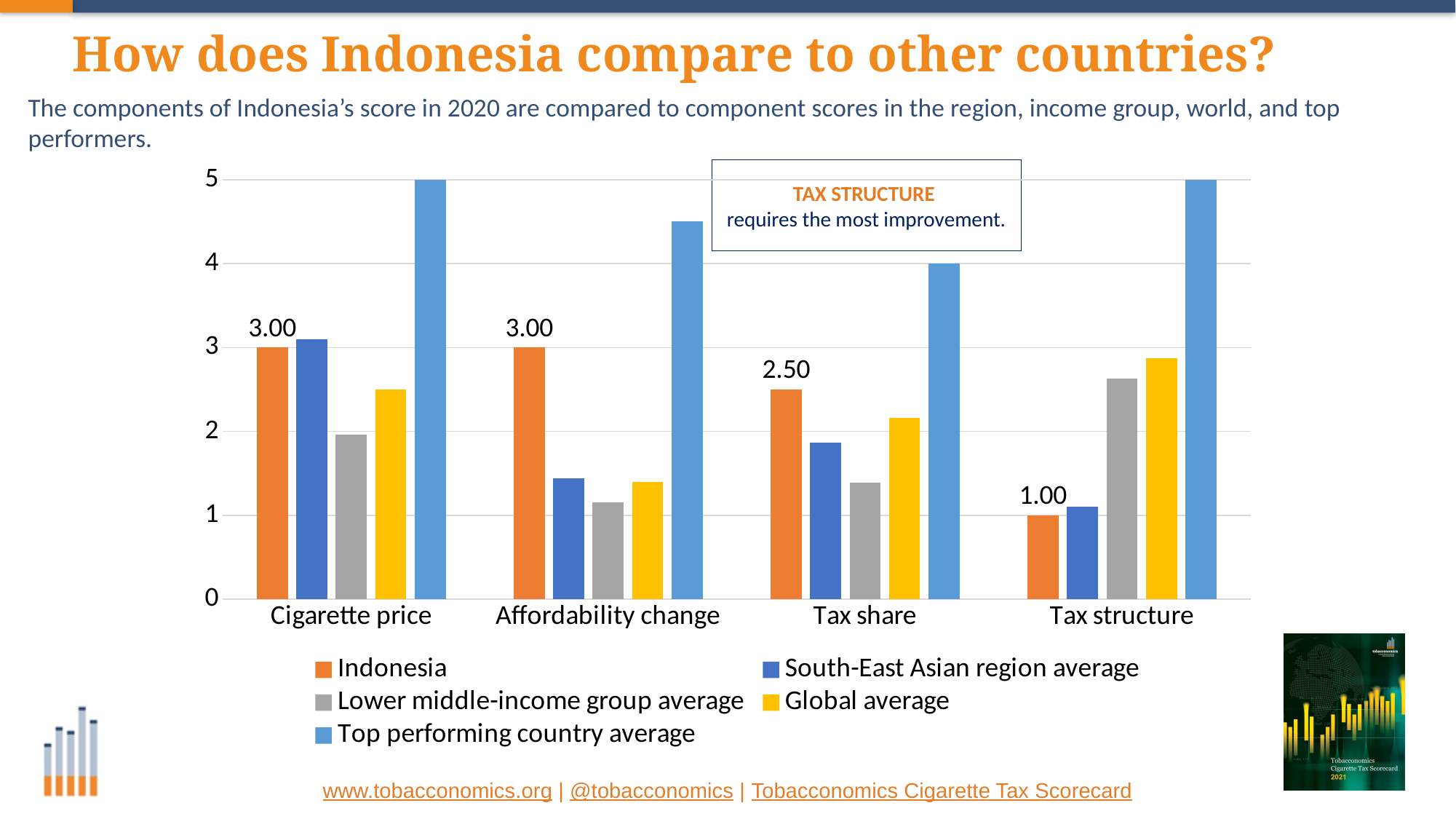
Is the Top performing country average for Affordability change greater or less than 4? greater How many components (categories) are shown on the x axis? 4 What is Indonesia's score for Cigarette price? 3.00 What is the Top performing country average for Cigarette price? 5 In which component does Indonesia have its lowest score? Tax structure What is Indonesia's score for Tax share? 2.50 What kind of chart is shown on the slide? bar chart Is the South-East Asian region average for Affordability change greater or less than 2? less For Tax structure, which is larger: Indonesia or the Top performing country average? Top performing country average What is the difference between Indonesia's Cigarette price score and its Tax structure score? 2.00 What is Indonesia's score for Tax structure? 1.00 How many series does the legend list? 5